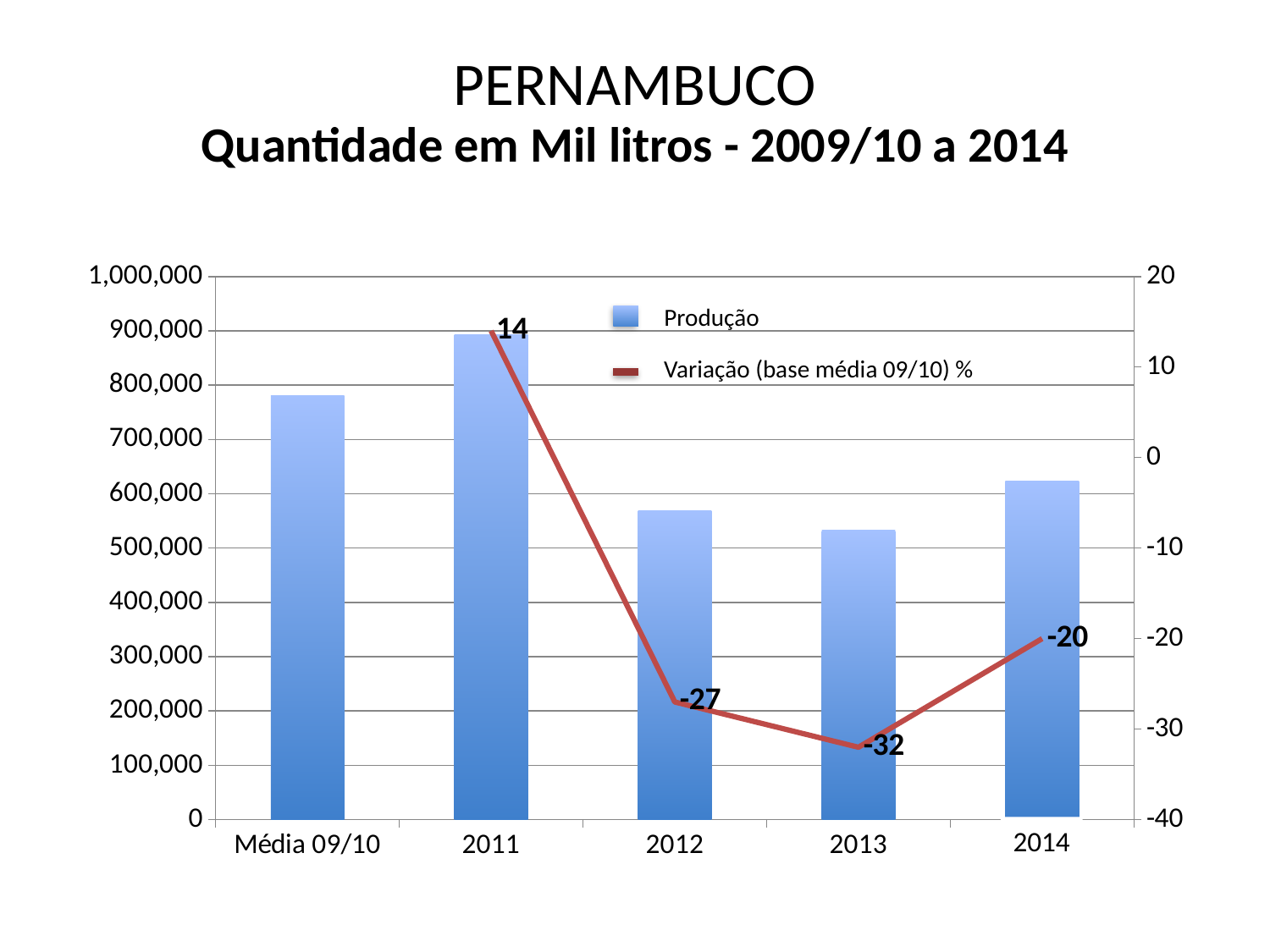
What is the Variação (base média 09/10) % value for 2013? -32 What is the Variação (base média 09/10) % value for 2011? 14 Which category has the highest Produção bar? 2011 Is the Produção value for 2012 greater or less than 600,000? less How many categories are shown on the x axis? 5 Is the Produção bar for Média 09/10 taller than the bar for 2014? Yes Which category has the lowest Produção bar? 2013 Which year has the lowest Variação (base média 09/10) % value? 2013 What is the difference between the Variação values for 2012 and 2013? 5 What is the Variação (base média 09/10) % value for 2014? -20 Is the Produção value for 2014 greater or less than 600,000? greater How many series does the legend list? 2